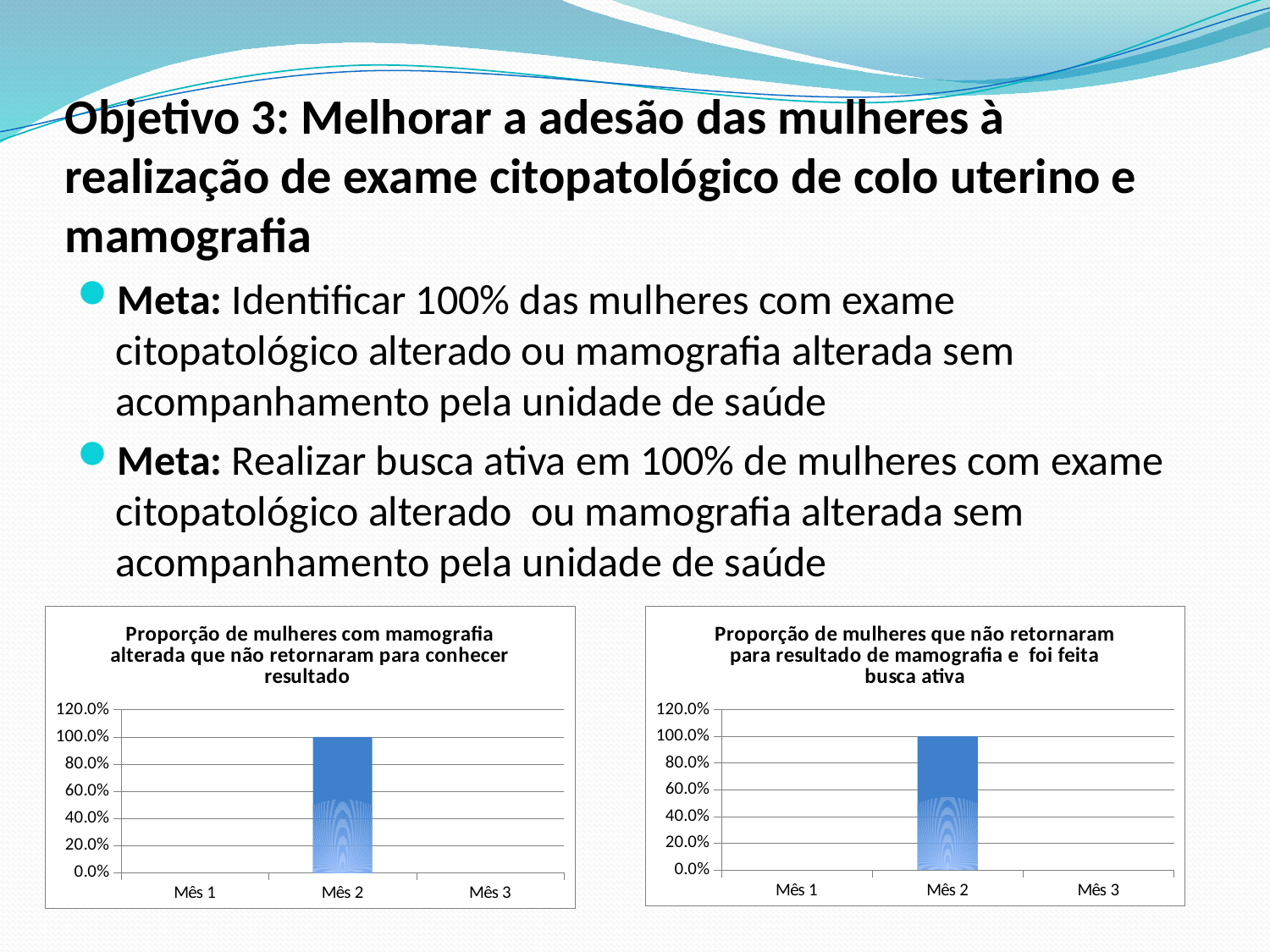
How many categories are shown on the x axis of the right chart? 3 In the right chart, which month has the highest value? Mês 2 In the left chart, which is larger, the value for Mês 1 or the value for Mês 2? Mês 2 In the right chart, is the value for Mês 2 greater or less than 60.0%? greater What kind of chart is the right chart? Bar chart How many categories are shown on the x axis of the left chart? 3 In the left chart, 'Proporção de mulheres com mamografia alterada que não retornaram para conhecer resultado', what is the value for Mês 2? 100.0% In the right chart, 'Proporção de mulheres que não retornaram para resultado de mamografia e foi feita busca ativa', what is the value for Mês 2? 100.0% In the left chart, is the value for Mês 2 greater or less than 80.0%? greater What kind of chart is the left chart? Bar chart What is the highest value shown on the y axis of the right chart? 120.0% In the left chart, which month has the highest value? Mês 2